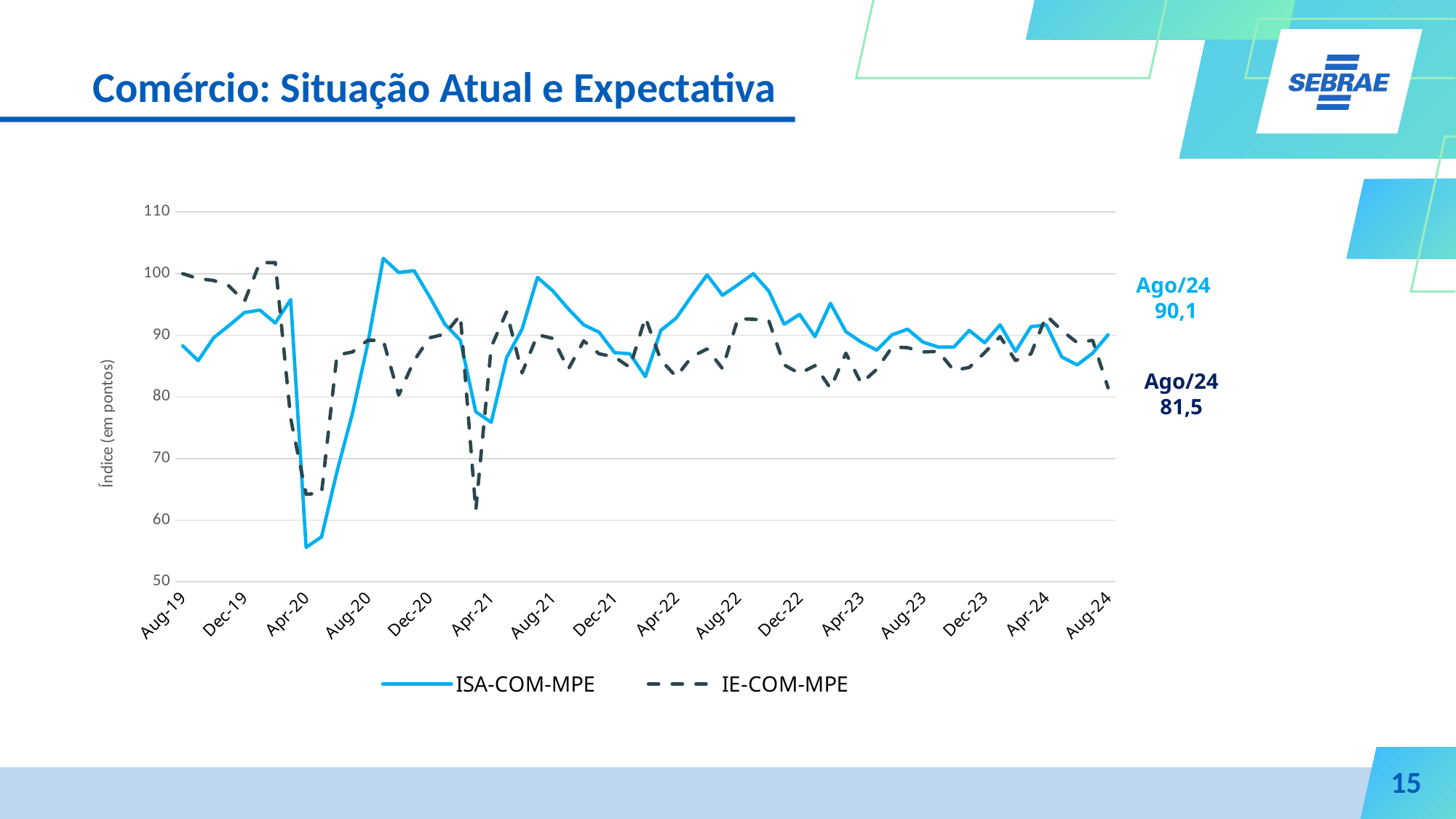
What is the title of the slide containing the chart? Comércio: Situação Atual e Expectativa What kind of chart is shown on the slide? line chart Is the value for IE-COM-MPE at Apr-21 greater or less than 70? greater Which series reaches the lowest point anywhere on the chart? ISA-COM-MPE Is the value for ISA-COM-MPE at Apr-20 greater or less than 60? less Is the value for IE-COM-MPE at Aug-19 greater or less than 90? greater What is the value of ISA-COM-MPE in Ago/24? 90,1 What is the label of the vertical axis? Índice (em pontos) What is the value of IE-COM-MPE in Ago/24? 81,5 Which series has the higher value in Ago/24, ISA-COM-MPE or IE-COM-MPE? ISA-COM-MPE How many series does the legend list? 2 What is the difference between the ISA-COM-MPE and IE-COM-MPE values in Ago/24? 8,6